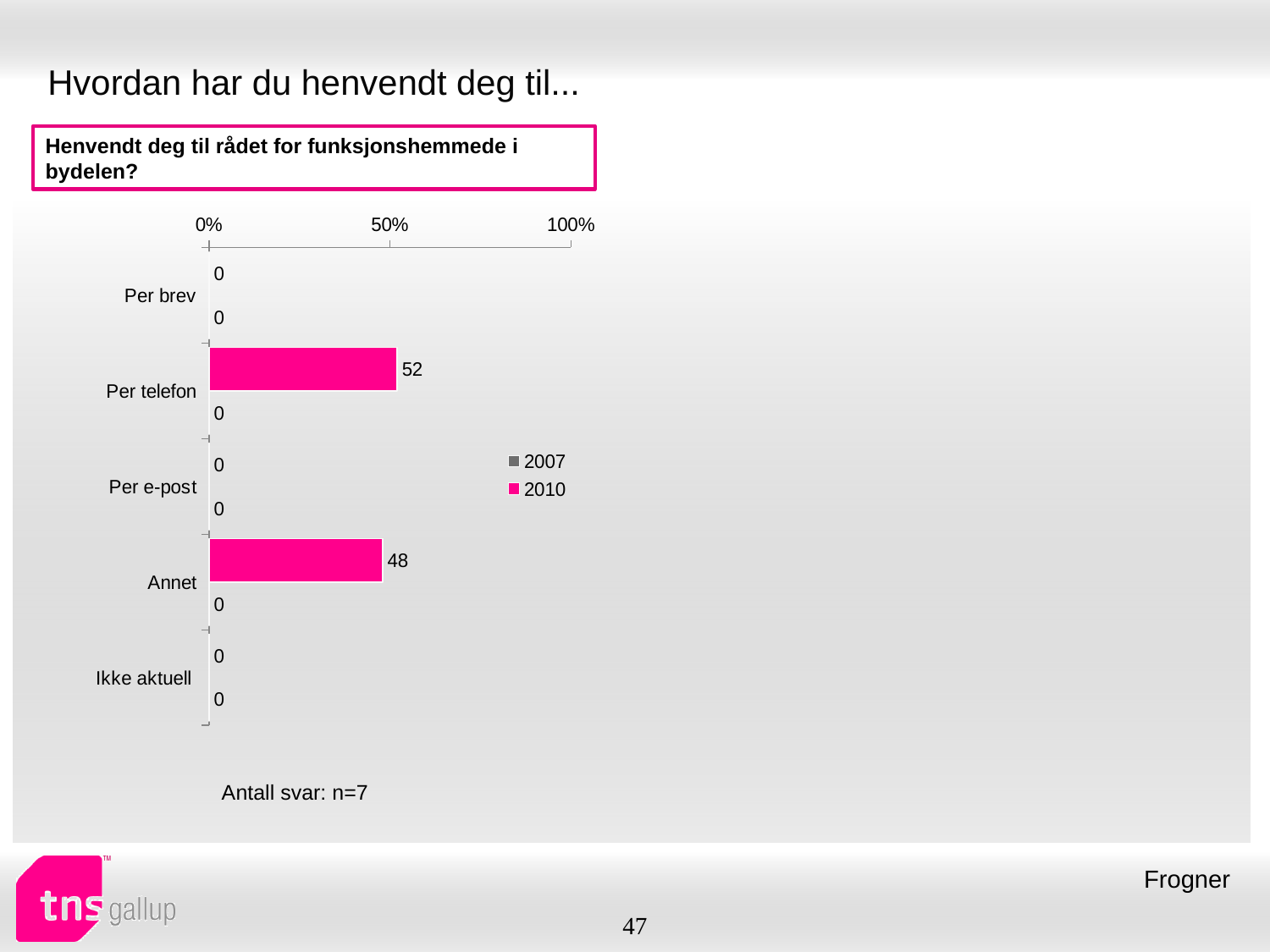
What kind of chart is shown on the slide? Bar chart What is the value for Per telefon in the 2007 series? 0 What is the difference between the 2010 values for Per telefon and Annet? 4 How many series does the legend list? 2 Which is larger in the 2010 series: Per telefon or Annet? Per telefon Which series is shown in pink according to the legend? 2010 Is the 2010 value for Per telefon greater or less than 50%? greater How many categories are shown on the chart? 5 What is the value for Per telefon in the 2010 series? 52 What is the value for Annet in the 2010 series? 48 Which category has the highest value in the 2010 series? Per telefon What is the value for Per brev in the 2010 series? 0